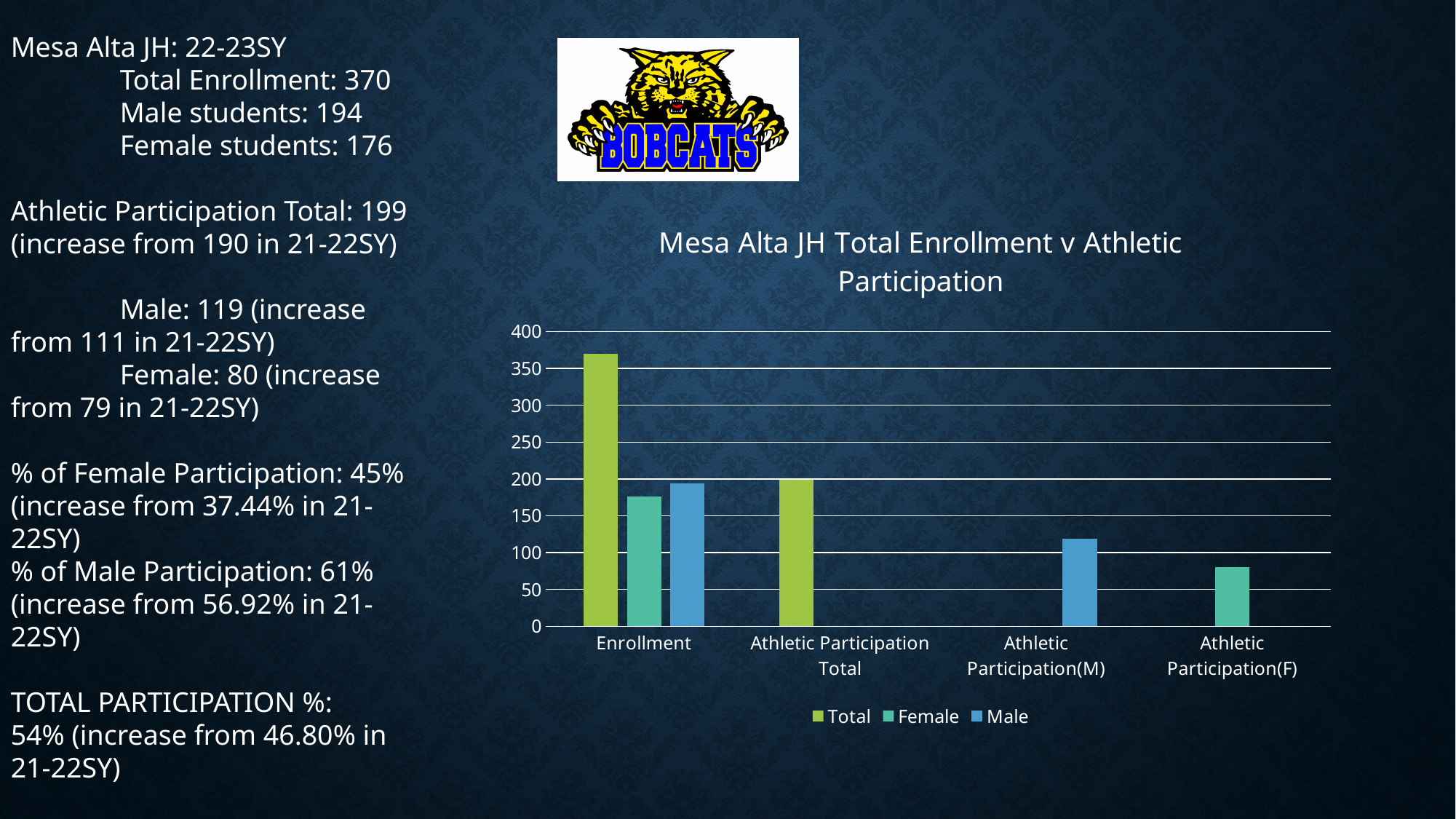
How many series does the chart legend list? 3 What is the title of the chart? Mesa Alta JH Total Enrollment v Athletic Participation Which is larger, the Male bar for Athletic Participation(M) or the Female bar for Athletic Participation(F)? Male bar for Athletic Participation(M) In the Enrollment category, which is larger, the Male bar or the Female bar? Male Is the Female value for Athletic Participation(F) greater or less than 100? less Is the Male value for Athletic Participation(M) greater or less than 100? greater What kind of chart is shown on the slide? bar chart Is the Total value for Enrollment greater or less than 350? greater Which bar in the chart is the shortest? Female for Athletic Participation(F) Which bar in the chart is the tallest? Total for Enrollment How many categories are shown on the x axis of the chart? 4